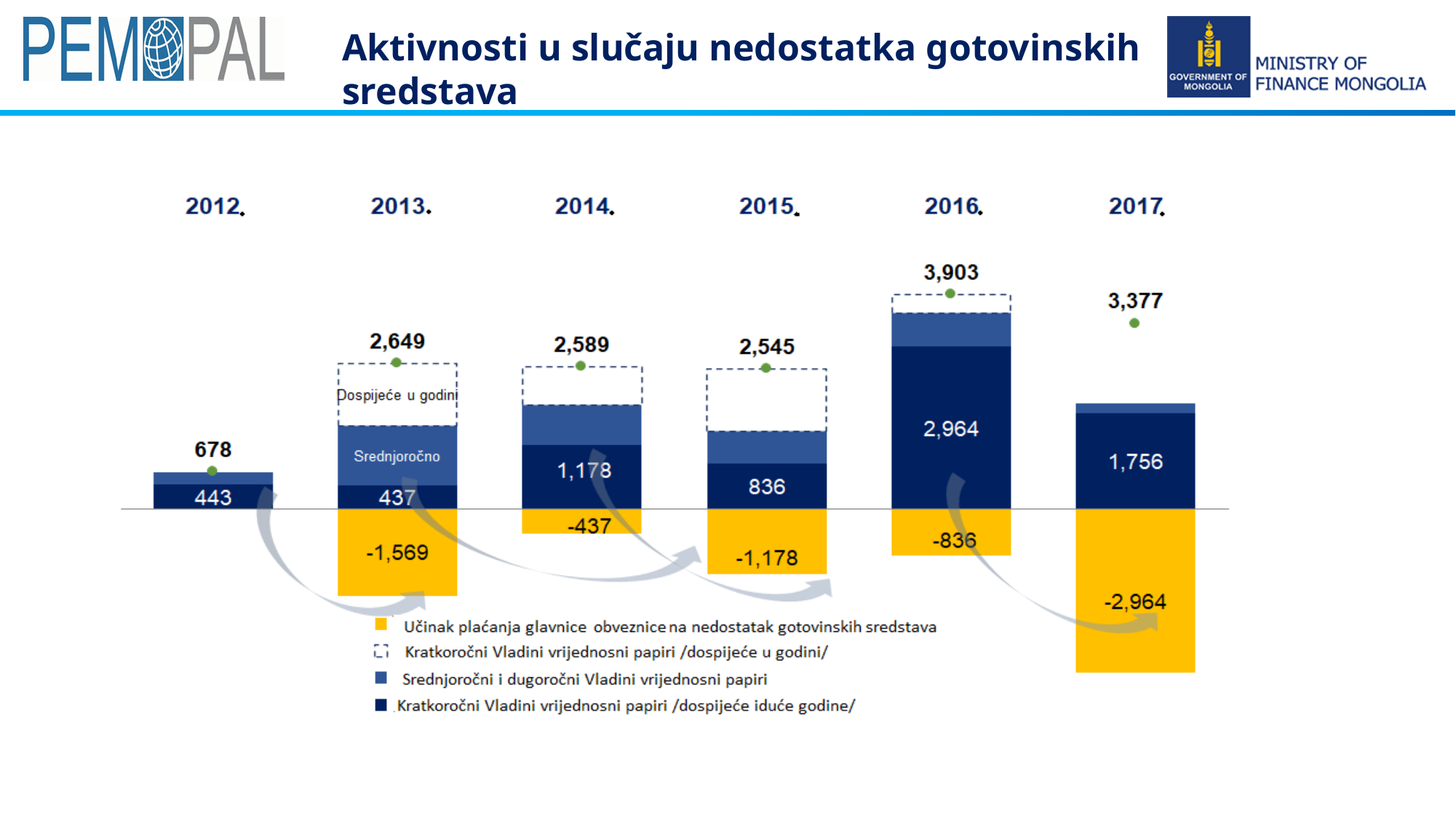
Which year has the lowest total value shown above its bar? 2012 What is the value of the yellow segment (Učinak plaćanja glavnice obveznice) for 2013? -1,569 What is the value of the dark blue segment (Kratkoročni Vladini vrijednosni papiri /dospijeće iduće godine/) for 2014? 1,178 What is the difference between the total values for 2016 and 2017? 526 Which is larger, the dark blue segment for 2015 or the dark blue segment for 2016? 2016 How many years are shown on the x axis of the chart? 6 What is the value of the dark blue segment for 2017? 1,756 What kind of chart is shown on the slide? Stacked bar chart What is the total value shown above the bar for 2016? 3,903 What is the value of the yellow segment for 2017? -2,964 Which year has the highest total value shown above its bar? 2016 How many entries does the legend list? 4